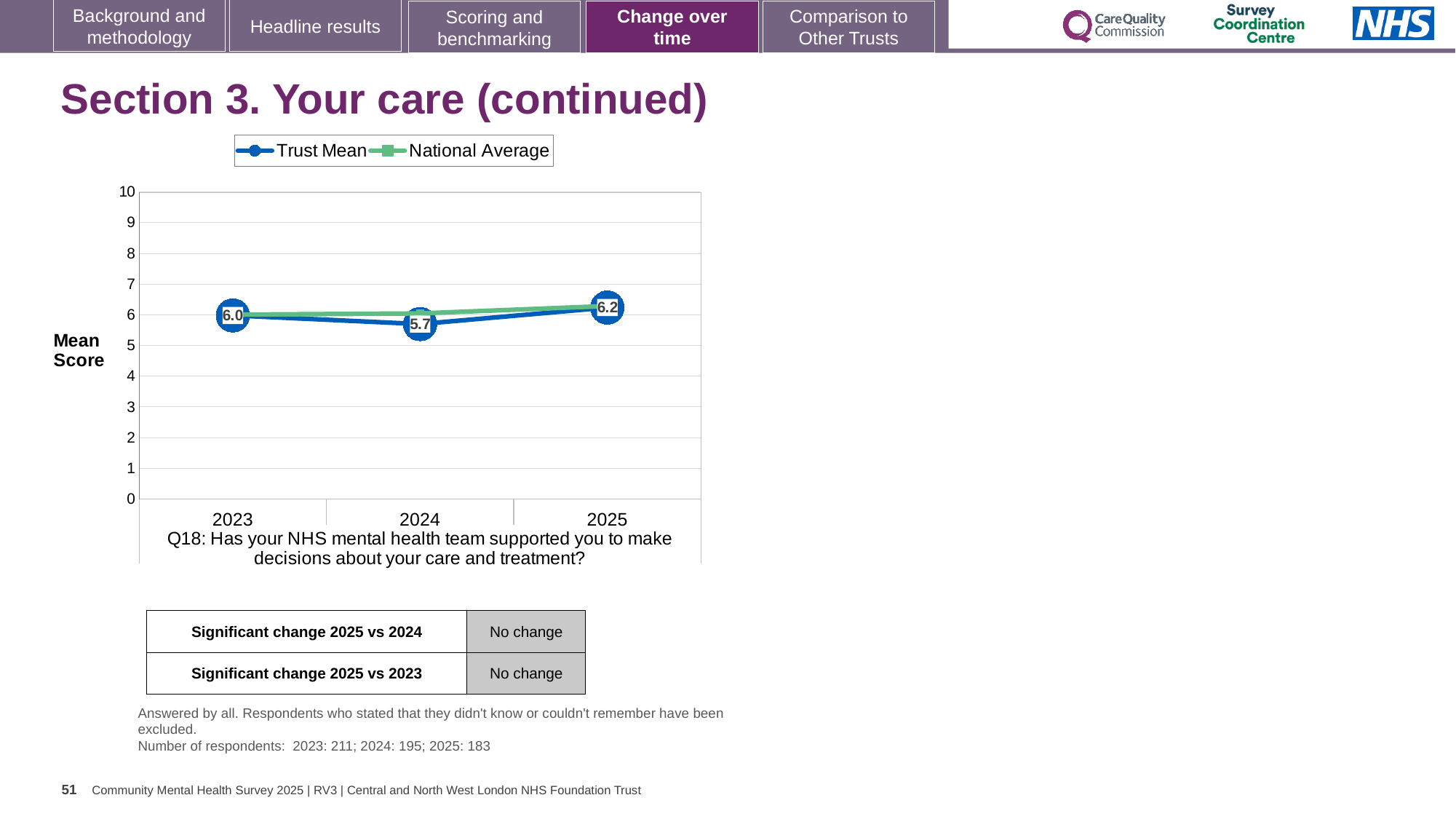
What is the Trust Mean value for 2023? 6.0 How many years are plotted on the x axis? 3 How many series does the legend list? 2 Is the National Average value for 2024 greater or less than 7? less In which year is the Trust Mean lowest? 2024 In which year is the Trust Mean highest? 2025 What kind of chart is shown on the slide? Line chart Does the Trust Mean rise or fall from 2024 to 2025? Rise What is the Trust Mean value for 2024? 5.7 What is the difference between the Trust Mean in 2025 and in 2024? 0.5 Which is larger, the Trust Mean for 2023 or for 2024? 2023 What is the Trust Mean value for 2025? 6.2